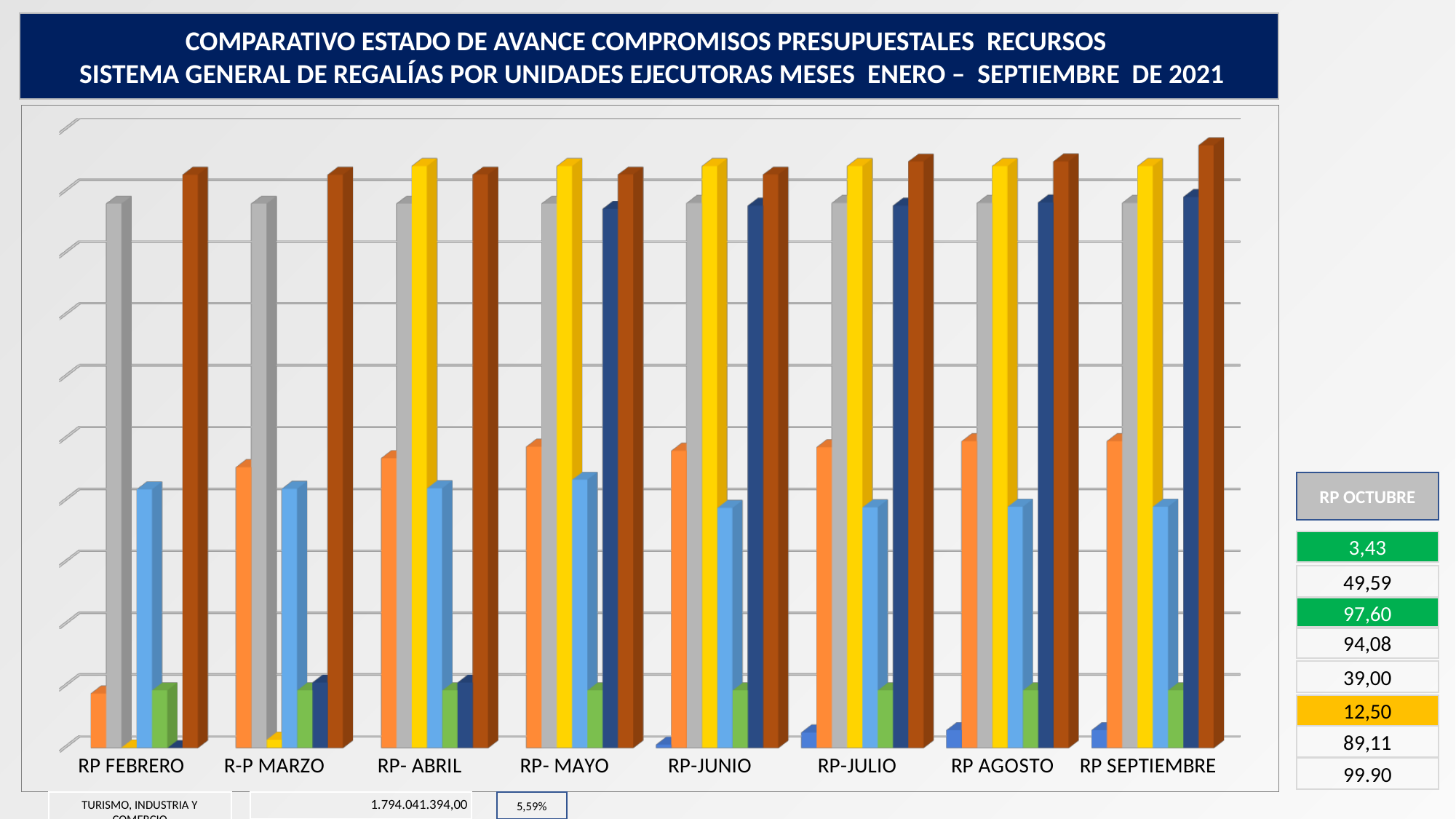
Which category has the tallest brown bar? RP SEPTIEMBRE In the RP SEPTIEMBRE group, which bar is the tallest? the brown bar In the RP FEBRERO group, which is larger, the brown bar or the light blue bar? the brown bar Do the orange bars rise or fall from RP FEBRERO to RP SEPTIEMBRE? rise How many categories are shown along the x axis of the chart? 8 In the RP- ABRIL group, which is larger, the yellow bar or the gray bar? the yellow bar What kind of chart is shown on the slide? bar chart Do the dark blue bars rise or fall from RP- ABRIL to RP- MAYO? rise In the RP FEBRERO group, which is larger, the orange bar or the light blue bar? the light blue bar What is the label of the last category on the x axis? RP SEPTIEMBRE What is the label of the first category on the x axis? RP FEBRERO